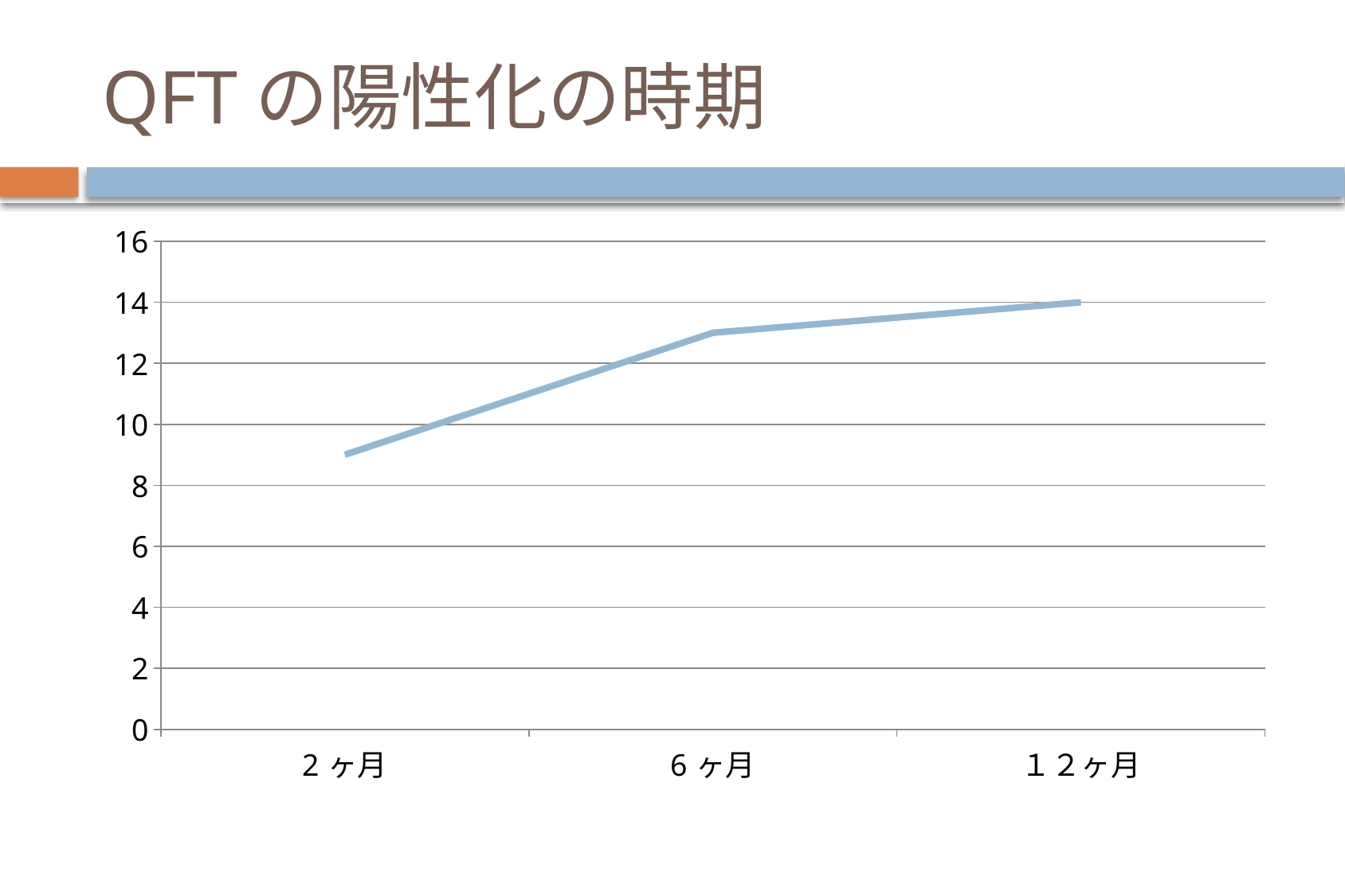
What kind of chart is shown on the slide? line chart Is the value for ６ヶ月 greater or less than 12? greater Is the value for ６ヶ月 greater or less than 14? less What is the title of the chart? QFT の陽性化の時期 Do the values rise or fall from ２ヶ月 to １２ヶ月? rise Which category has the lowest value? ２ヶ月 Which category has the highest value? １２ヶ月 Is the value for ２ヶ月 greater or less than 8? greater How many data points are plotted on the line? 3 Which is larger, the value at ２ヶ月 or the value at ６ヶ月? ６ヶ月 What is the value at １２ヶ月? 14